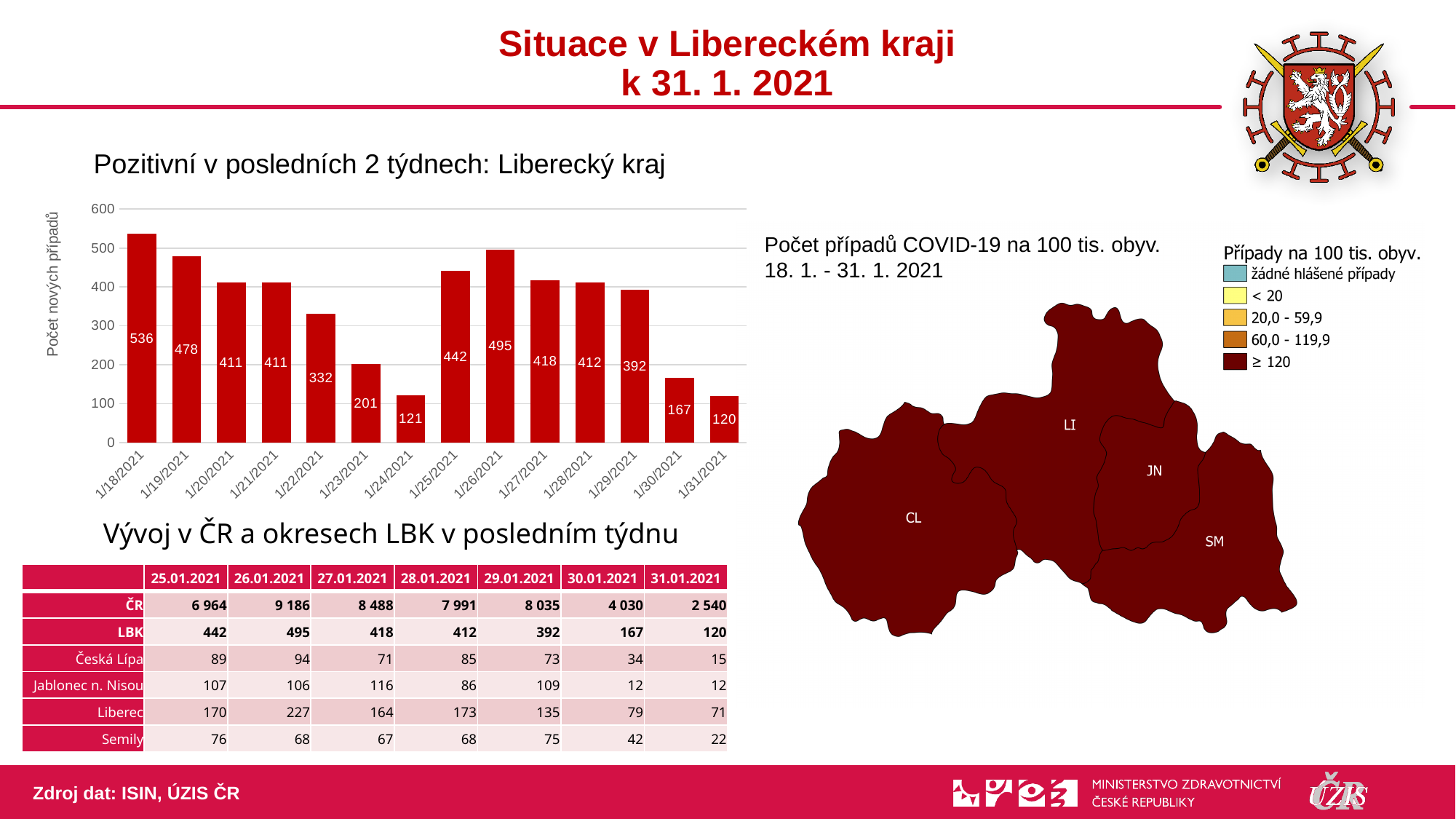
In the bar chart, what is the difference between the values for 1/18/2021 and 1/19/2021? 58 How many bars (dates) are shown in the bar chart? 14 In the bar chart, what is the value for 1/26/2021? 495 Which date has the highest bar in the bar chart? 1/18/2021 In the bar chart, is the value for 1/30/2021 greater or less than 200? less Which date has the lowest bar in the bar chart? 1/31/2021 In the bar chart, what is the value for 1/24/2021? 121 In the bar chart, which is larger, the value for 1/22/2021 or the value for 1/23/2021? 1/22/2021 What is the label on the vertical axis of the bar chart? Počet nových případů In the bar chart, what is the difference between the values for 1/26/2021 and 1/25/2021? 53 What type of chart is shown under the title "Pozitivní v posledních 2 týdnech: Liberecký kraj"? bar chart In the bar chart, what is the value for 1/18/2021? 536